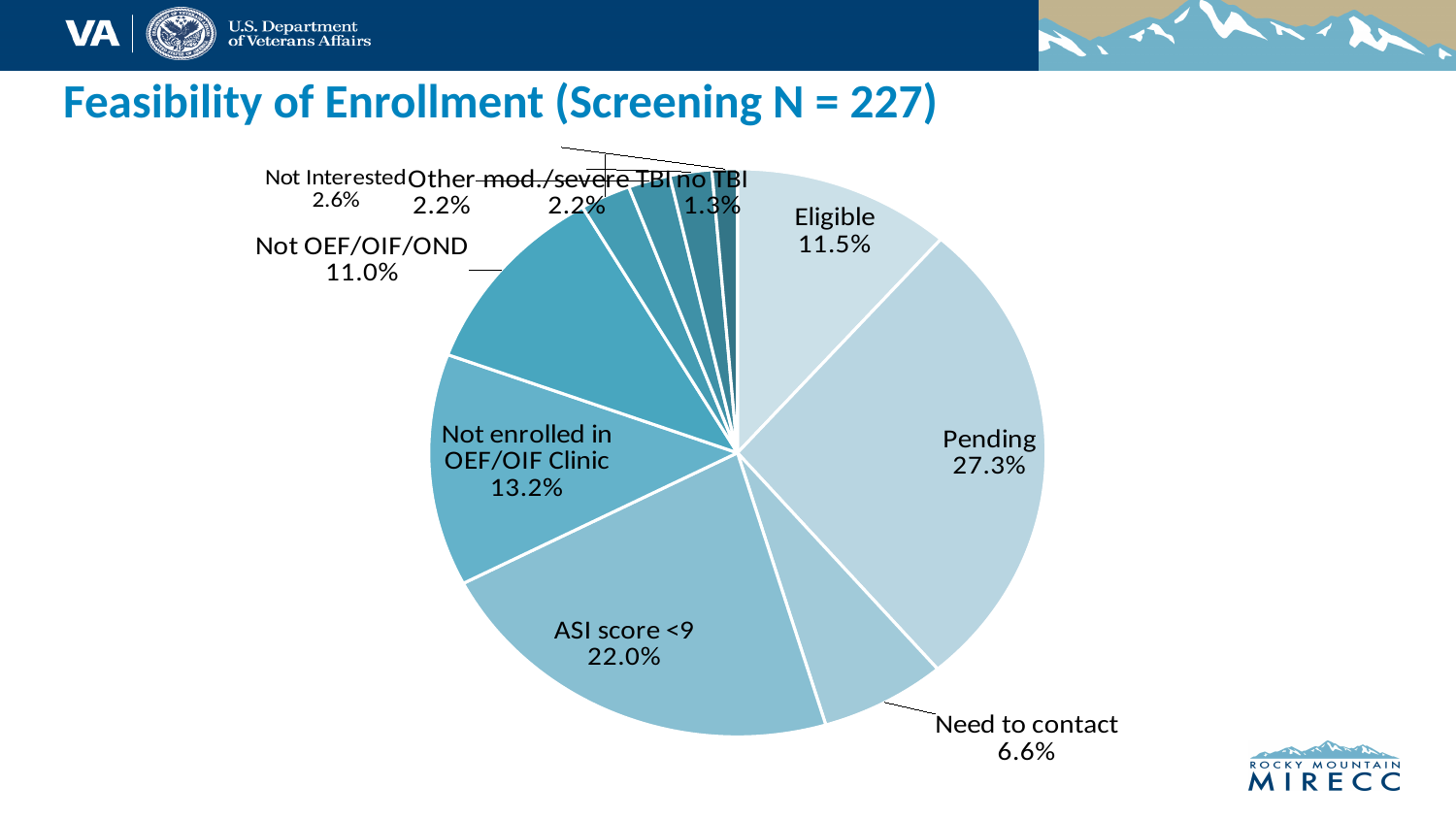
What percentage of the pie is labelled Need to contact? 6.6% What percentage of the pie is labelled Pending? 27.3% What type of chart is shown on the slide? Pie chart How many slices does the pie chart have? 10 Which is larger, the share for Not OEF/OIF/OND or the share for Not enrolled in OEF/OIF Clinic? Not enrolled in OEF/OIF Clinic What is the difference in percentage points between Pending and ASI score <9? 5.3 Which category has the largest share of the pie? Pending What percentage of the pie is labelled ASI score <9? 22.0% What percentage of the pie is labelled Eligible? 11.5% Which category has the smallest share of the pie? no TBI What percentage of the pie is labelled Not enrolled in OEF/OIF Clinic? 13.2% What is the screening N given in the slide title? 227